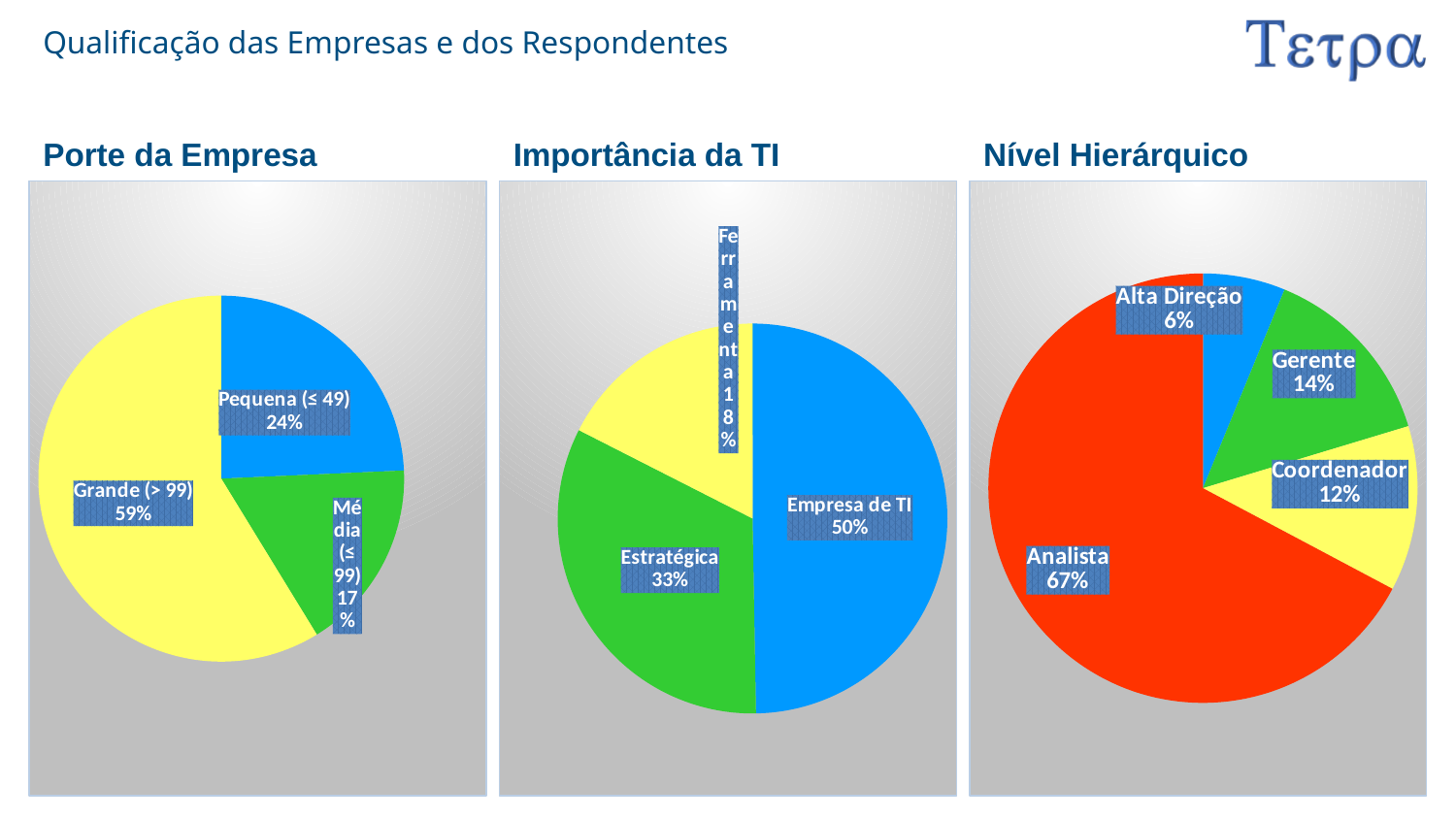
How many slices does the 'Nível Hierárquico' chart have? 4 In the 'Nível Hierárquico' chart, which is larger, Coordenador or Alta Direção? Coordenador How many slices does the 'Porte da Empresa' chart have? 3 In the 'Porte da Empresa' chart, which category has the smallest slice? Média (≤ 99) In the 'Nível Hierárquico' chart, what share is labelled for Gerente? 14% In the 'Importância da TI' chart, which category has the largest slice? Empresa de TI In the 'Porte da Empresa' chart, what share is labelled for Grande (> 99)? 59% How many pie charts are shown on the slide? 3 In the 'Porte da Empresa' chart, what is the difference between the Pequena (≤ 49) and Média (≤ 99) shares? 7% In the 'Importância da TI' chart, what share is labelled for Estratégica? 33% In the 'Importância da TI' chart, what share is labelled for Ferramenta? 18% What kind of chart is the 'Nível Hierárquico' chart? Pie chart